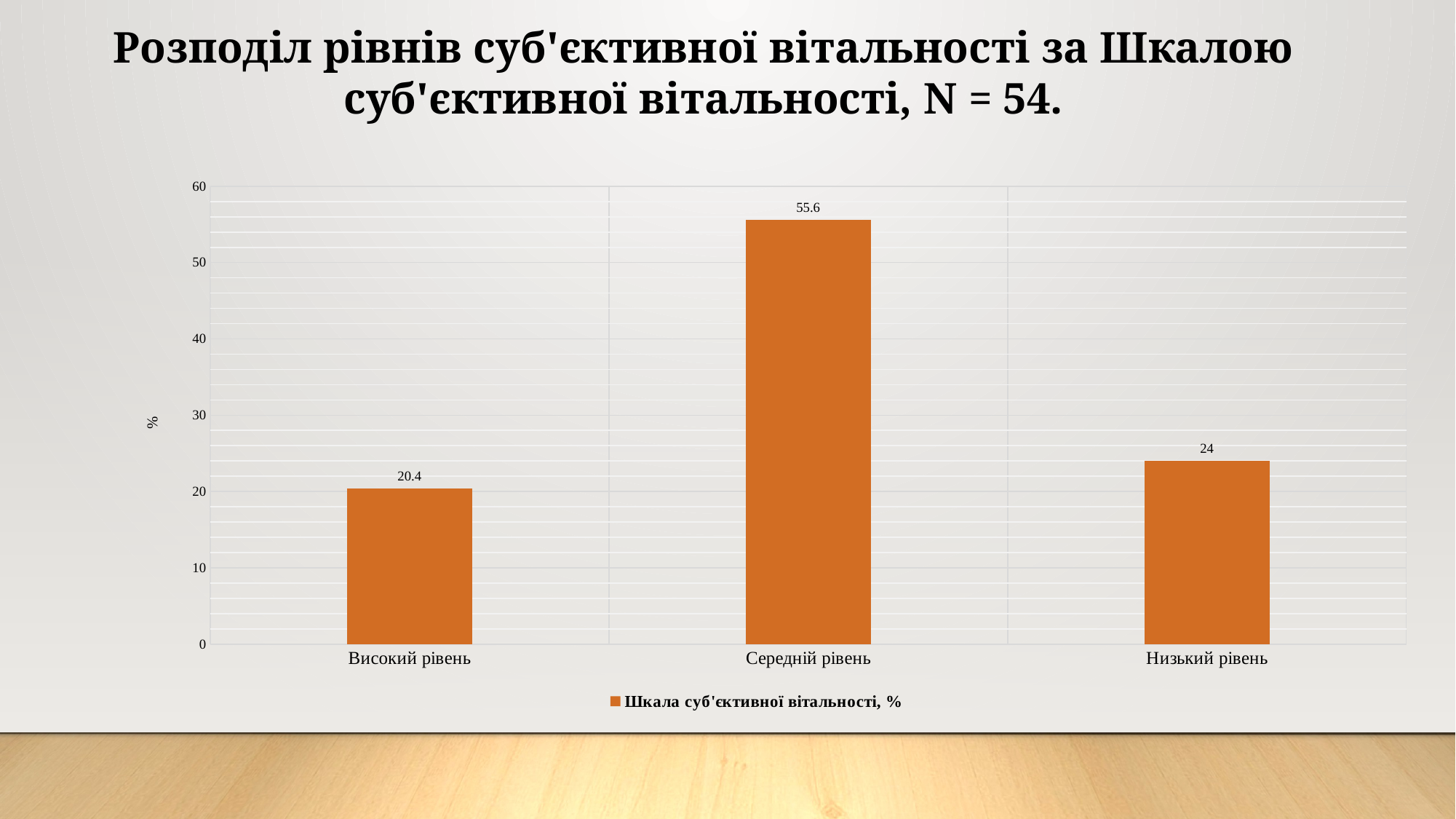
What kind of chart is shown on the slide? bar chart What is the difference between the values for Середній рівень and Низький рівень? 31.6 What is the value for Високий рівень? 20.4 What is the value for Середній рівень? 55.6 Which is larger, the value for Високий рівень or the value for Низький рівень? Низький рівень What is the legend entry shown below the chart? Шкала суб'єктивної вітальності, % What is the value for Низький рівень? 24 Is the value for Середній рівень greater or less than 50? greater Which category has the lowest value? Високий рівень Which category has the highest value? Середній рівень How many categories are shown on the x axis? 3 What is the difference between the values for Низький рівень and Високий рівень? 3.6